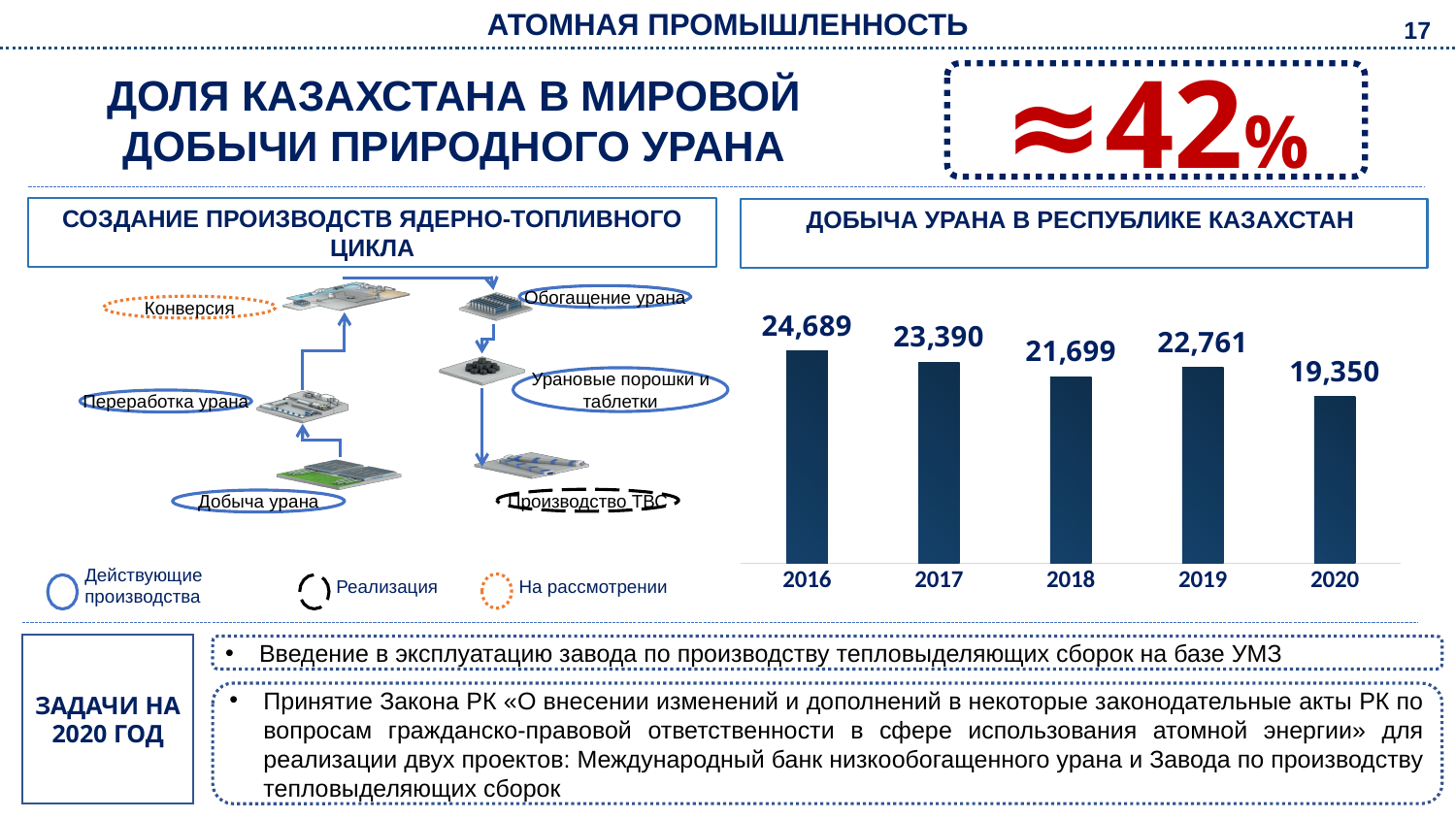
What kind of chart is 'ДОБЫЧА УРАНА В РЕСПУБЛИКЕ КАЗАХСТАН'? bar chart What is the value for 2016 in the chart 'ДОБЫЧА УРАНА В РЕСПУБЛИКЕ КАЗАХСТАН'? 24,689 Which year has the lowest value in the chart 'ДОБЫЧА УРАНА В РЕСПУБЛИКЕ КАЗАХСТАН'? 2020 What is the title of the bar chart on the right side of the slide? ДОБЫЧА УРАНА В РЕСПУБЛИКЕ КАЗАХСТАН Which year has the highest value in the chart 'ДОБЫЧА УРАНА В РЕСПУБЛИКЕ КАЗАХСТАН'? 2016 How many years are shown in the chart 'ДОБЫЧА УРАНА В РЕСПУБЛИКЕ КАЗАХСТАН'? 5 What is the value for 2020 in the chart 'ДОБЫЧА УРАНА В РЕСПУБЛИКЕ КАЗАХСТАН'? 19,350 What is the difference between the 2019 and 2018 values in the chart 'ДОБЫЧА УРАНА В РЕСПУБЛИКЕ КАЗАХСТАН'? 1,062 In the chart 'ДОБЫЧА УРАНА В РЕСПУБЛИКЕ КАЗАХСТАН', do the values generally rise or fall from 2016 to 2020? fall What is the value for 2018 in the chart 'ДОБЫЧА УРАНА В РЕСПУБЛИКЕ КАЗАХСТАН'? 21,699 In the chart 'ДОБЫЧА УРАНА В РЕСПУБЛИКЕ КАЗАХСТАН', which is larger, the value for 2018 or the value for 2019? 2019 What is the difference between the 2016 and 2017 values in the chart 'ДОБЫЧА УРАНА В РЕСПУБЛИКЕ КАЗАХСТАН'? 1,299